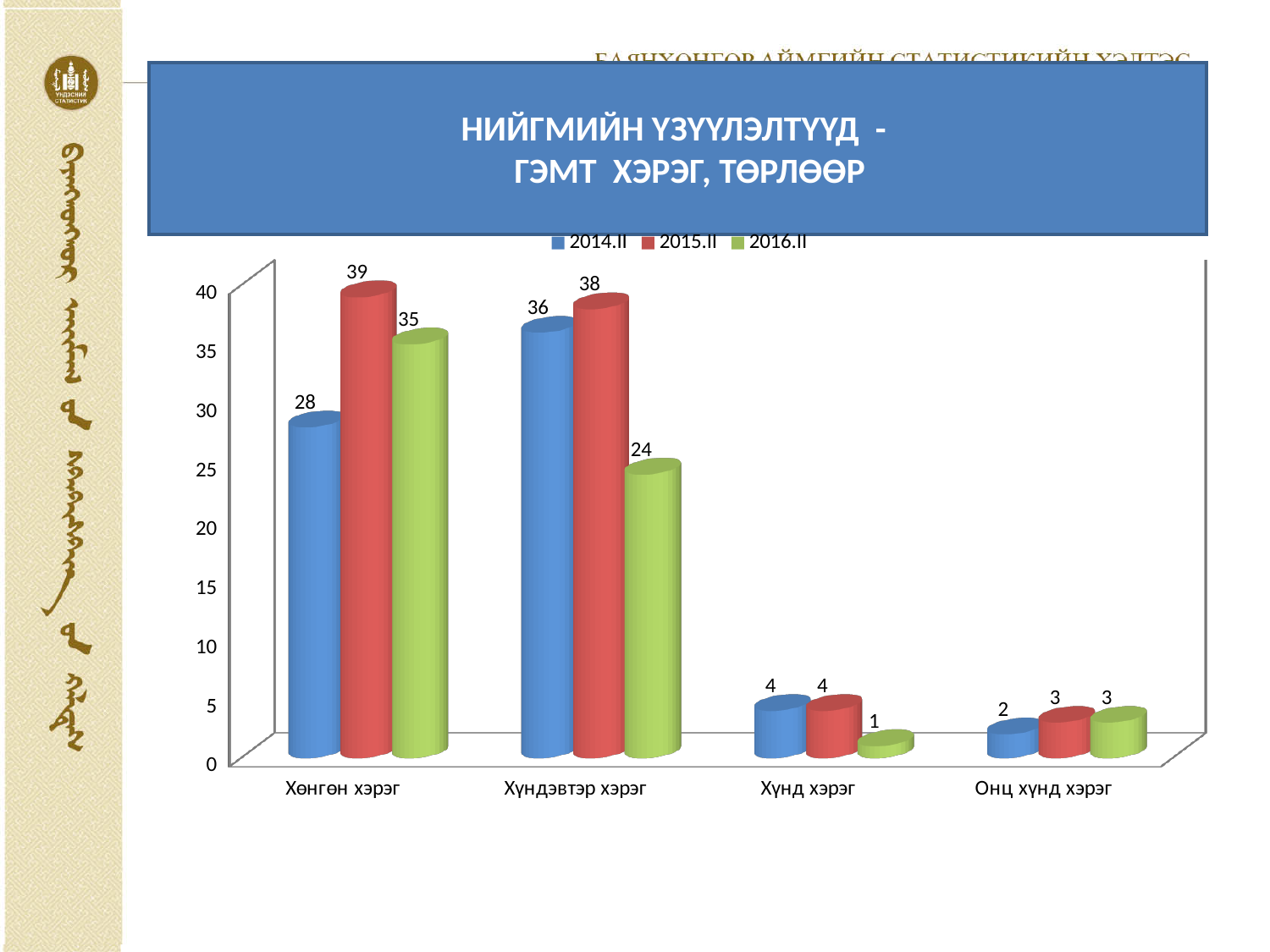
Which category has the highest value in the 2014.II series? Хүндэвтэр хэрэг What is the difference between the 2015.II and 2014.II values for Хөнгөн хэрэг? 11 What is the value for Хөнгөн хэрэг in the 2015.II series? 39 Which colour represents the 2016.II series? Green What is the value for Хүнд хэрэг in the 2014.II series? 4 How many categories are shown on the x axis? 4 What is the value for Хүндэвтэр хэрэг in the 2016.II series? 24 Which category has the lowest value in the 2016.II series? Хүнд хэрэг How many series does the legend list? 3 What kind of chart is shown on the slide? Bar chart Which is larger for Хүндэвтэр хэрэг: the 2014.II value or the 2016.II value? 2014.II What is the value for Онц хүнд хэрэг in the 2016.II series? 3